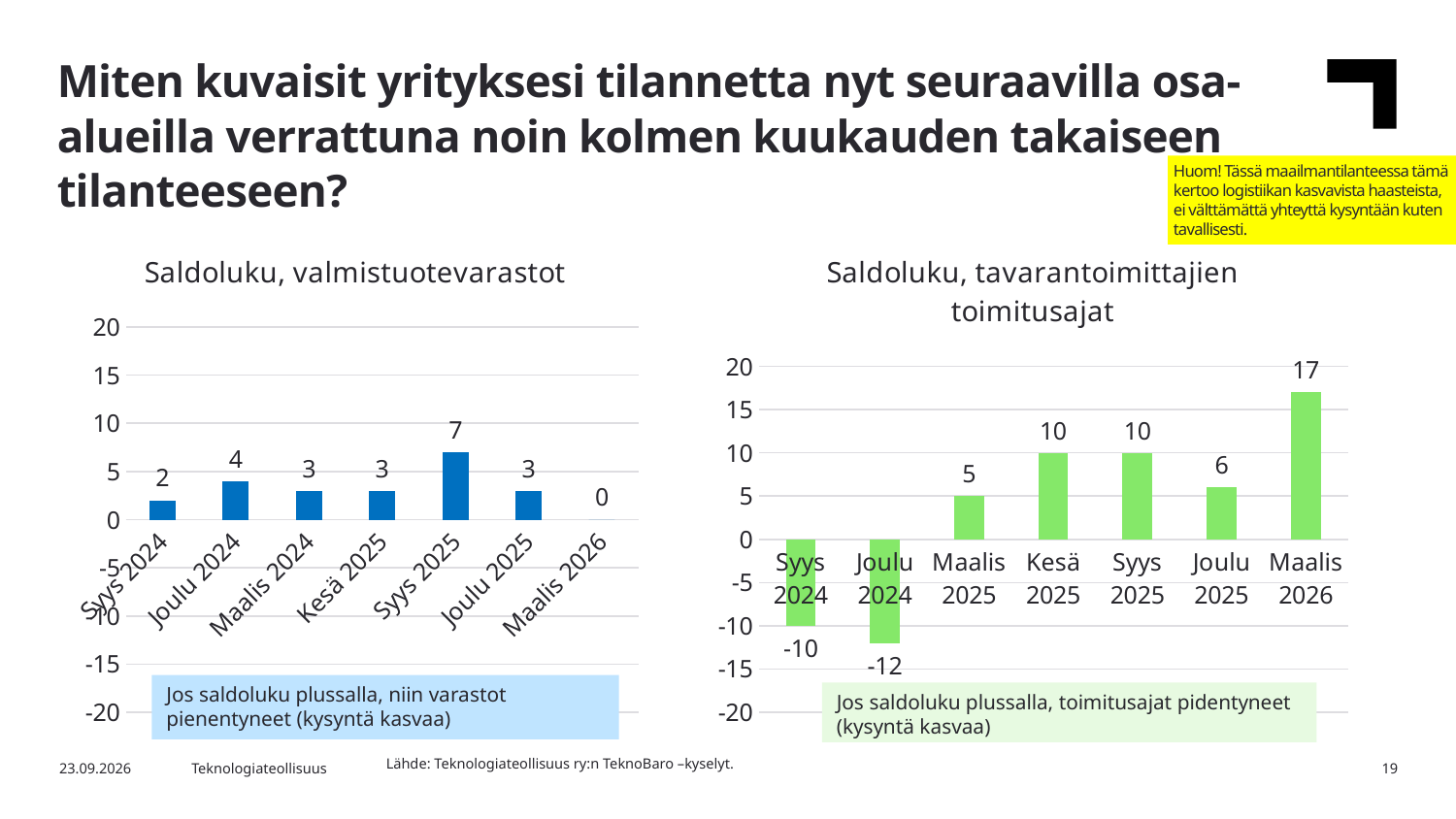
In the chart 'Saldoluku, valmistuotevarastot', what is the value for Syys 2025? 7 What colour are the bars in the chart 'Saldoluku, tavarantoimittajien toimitusajat'? Green In the chart 'Saldoluku, valmistuotevarastot', how many categories are shown on the x axis? 7 In the chart 'Saldoluku, tavarantoimittajien toimitusajat', what is the difference between the values for Maalis 2026 and Kesä 2025? 7 In the chart 'Saldoluku, valmistuotevarastot', what is the difference between the values for Joulu 2024 and Syys 2024? 2 What kind of chart is 'Saldoluku, tavarantoimittajien toimitusajat'? Bar chart In the chart 'Saldoluku, tavarantoimittajien toimitusajat', which category has the lowest value? Joulu 2024 In the chart 'Saldoluku, tavarantoimittajien toimitusajat', what is the value for Joulu 2024? -12 In the chart 'Saldoluku, valmistuotevarastot', what is the value for Maalis 2026? 0 In the chart 'Saldoluku, tavarantoimittajien toimitusajat', what is the value for Maalis 2026? 17 In the chart 'Saldoluku, valmistuotevarastot', which category has the highest value? Syys 2025 In the chart 'Saldoluku, tavarantoimittajien toimitusajat', which is larger, the value for Joulu 2025 or the value for Maalis 2025? Joulu 2025